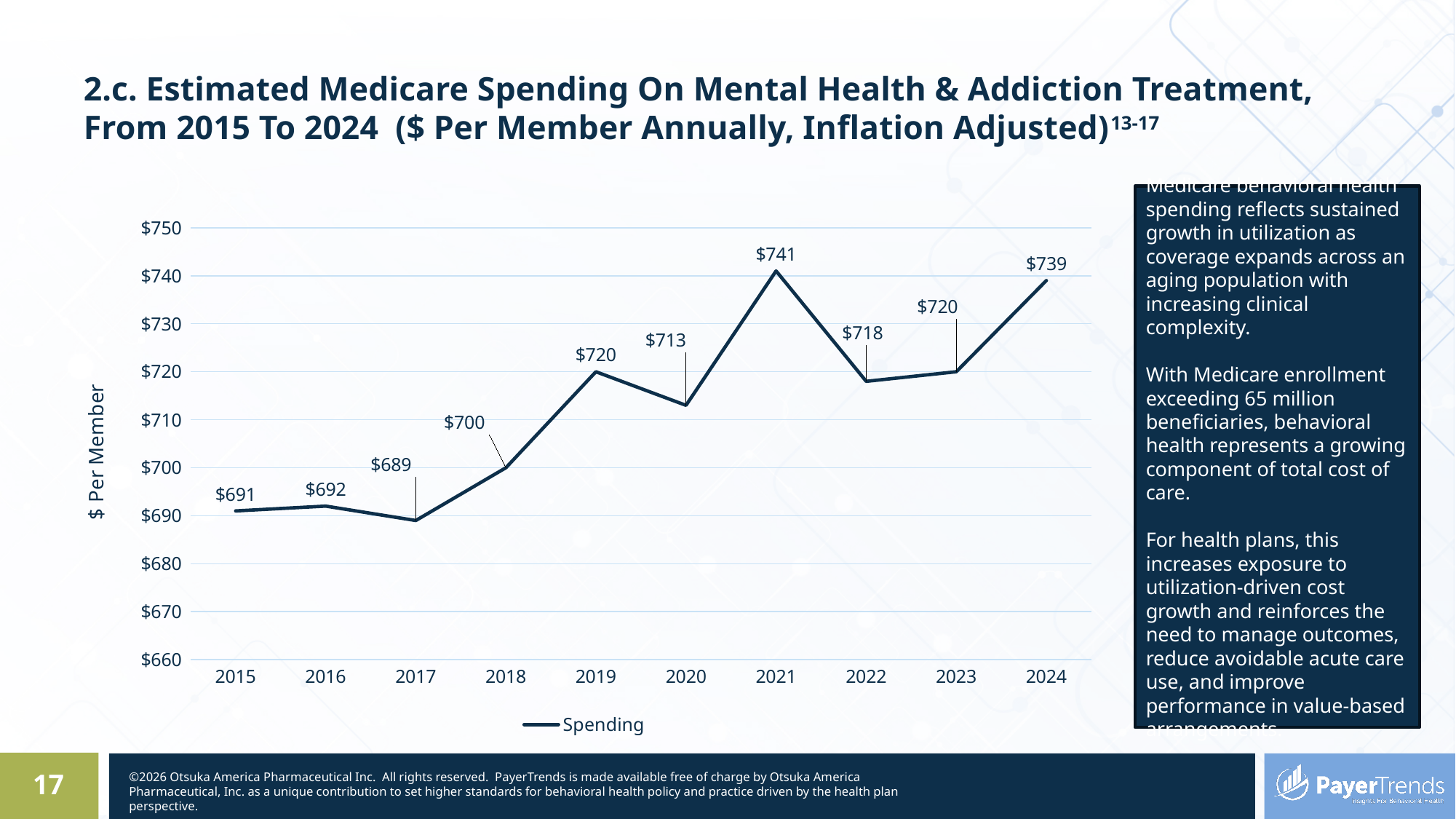
What is the estimated Medicare spending per member in 2021? $741 What is the estimated Medicare spending per member in 2024? $739 Which year has the highest estimated Medicare spending per member? 2021 What is the difference in spending per member between 2021 and 2020? $28 What kind of chart is shown on the slide? Line chart What is the estimated Medicare spending per member in 2015? $691 Is the value for 2022 greater or less than $710? greater How many years are plotted on the chart? 10 What is the difference in spending per member between 2024 and 2015? $48 Which year has the lowest estimated Medicare spending per member? 2017 Which year has higher spending per member, 2019 or 2020? 2019 What is the name of the series shown in the legend? Spending